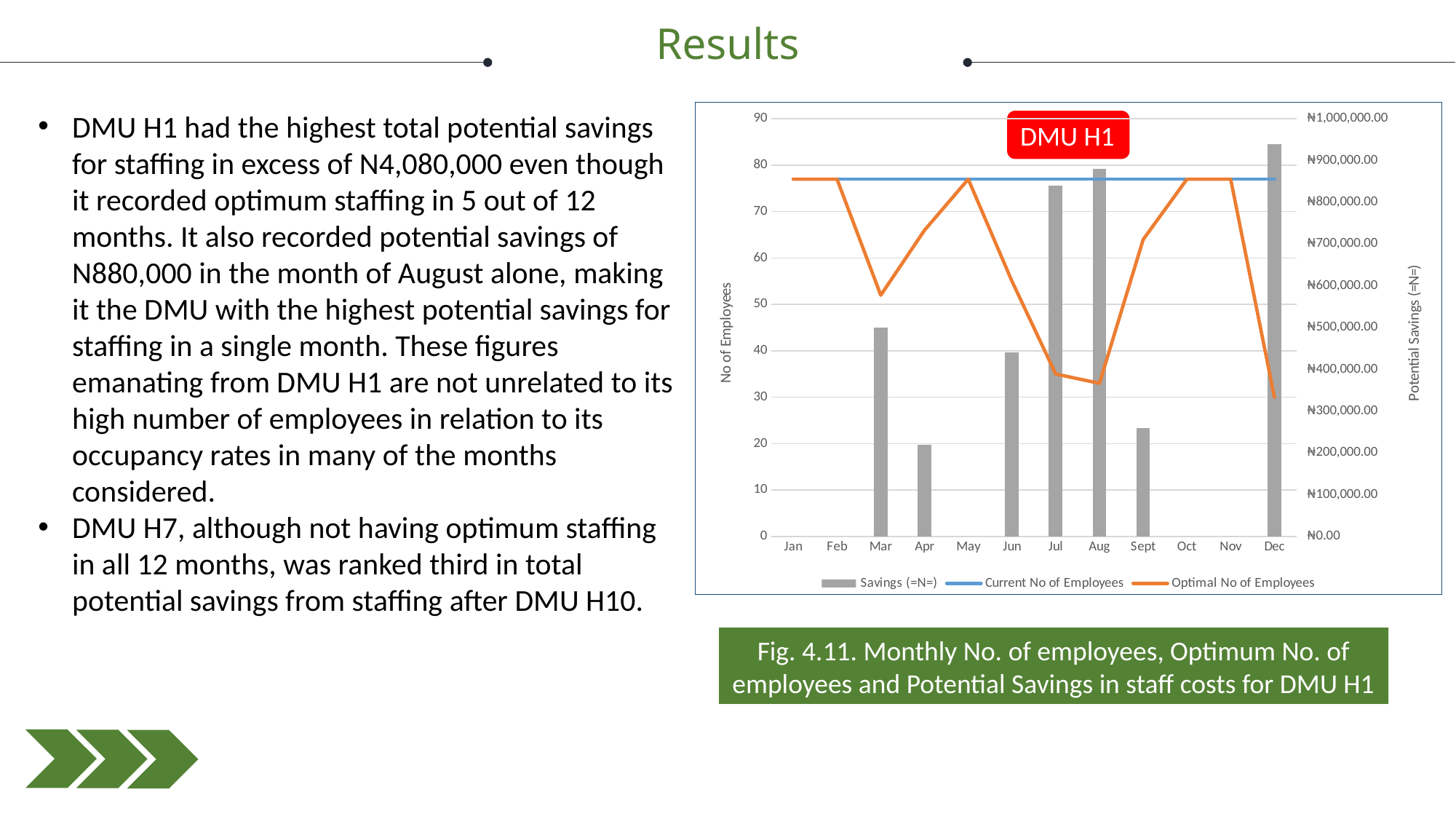
How many months are shown along the x axis of the chart? 12 In which month is the Savings bar the tallest? Dec What kind of chart is shown on the slide? A combination bar and line chart Is the Savings value for Jun greater or less than ₦500,000.00? less Is the Optimal No of Employees value for Mar greater or less than 60? less Which series is drawn as a blue line in the chart? Current No of Employees Which month has the larger Savings bar, Jul or Sept? Jul How many series does the chart legend list? 3 Is the Savings value for Dec greater or less than ₦900,000.00? greater How many months have a Savings bar plotted in the chart? 7 Among the months that have a Savings bar, which month has the shortest bar? Apr Does the Optimal No of Employees line rise or fall from Nov to Dec? fall